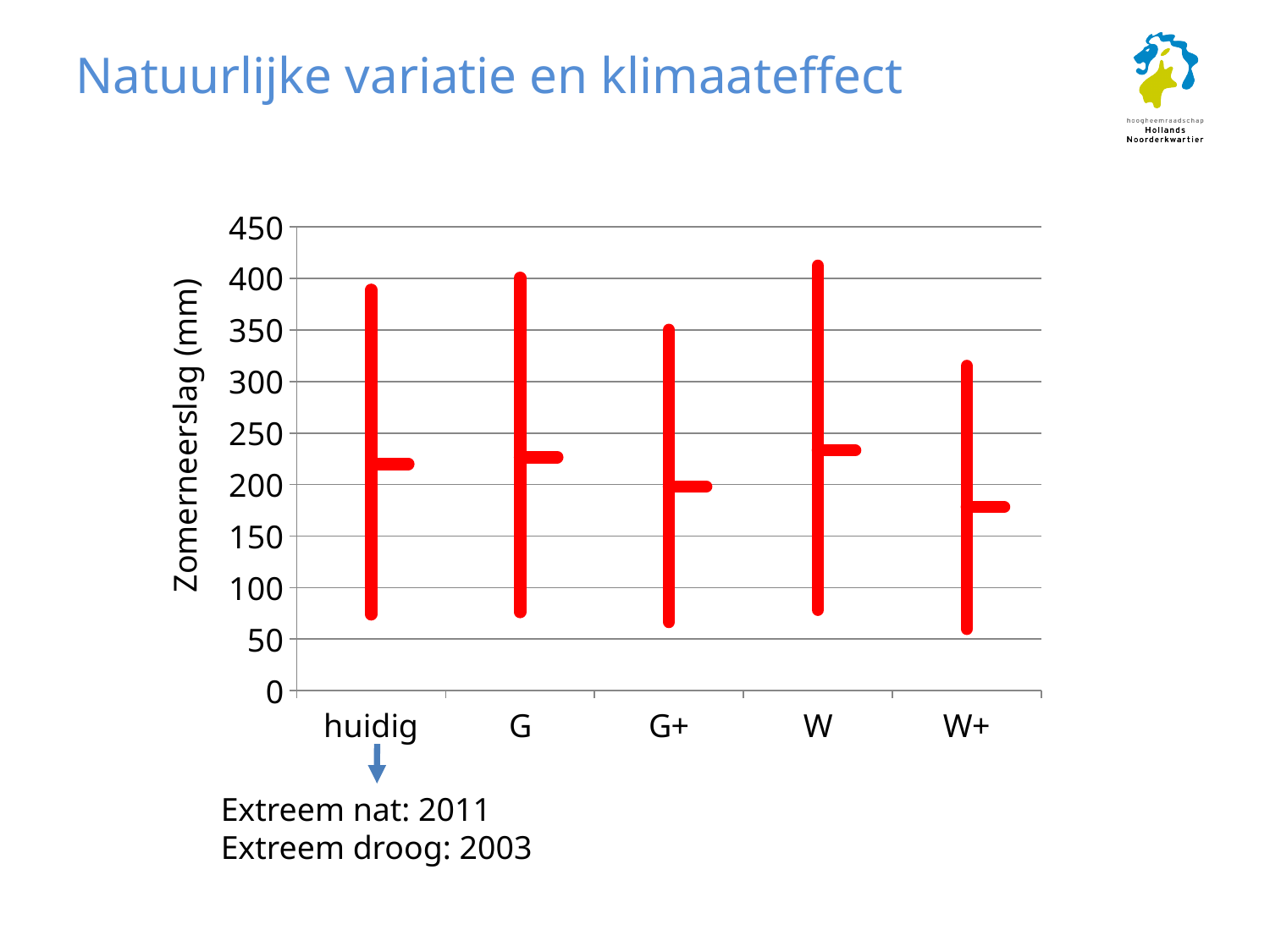
What is the title of the slide containing the chart? Natuurlijke variatie en klimaateffect Which category has the lowest lower end of its range? W+ How many scenario categories are shown on the x axis of the chart? 5 Which has a higher horizontal marker value, W or W+? W Which has a higher upper end of its range, G or W+? G Is the upper end of the range for huidig greater or less than 350? greater Which category has the highest upper end of its range? W Is the upper end of the range for W+ greater or less than 350? less What is the label of the y axis of the chart? Zomerneerslag (mm) Is the upper end of the range for W greater or less than 400? greater